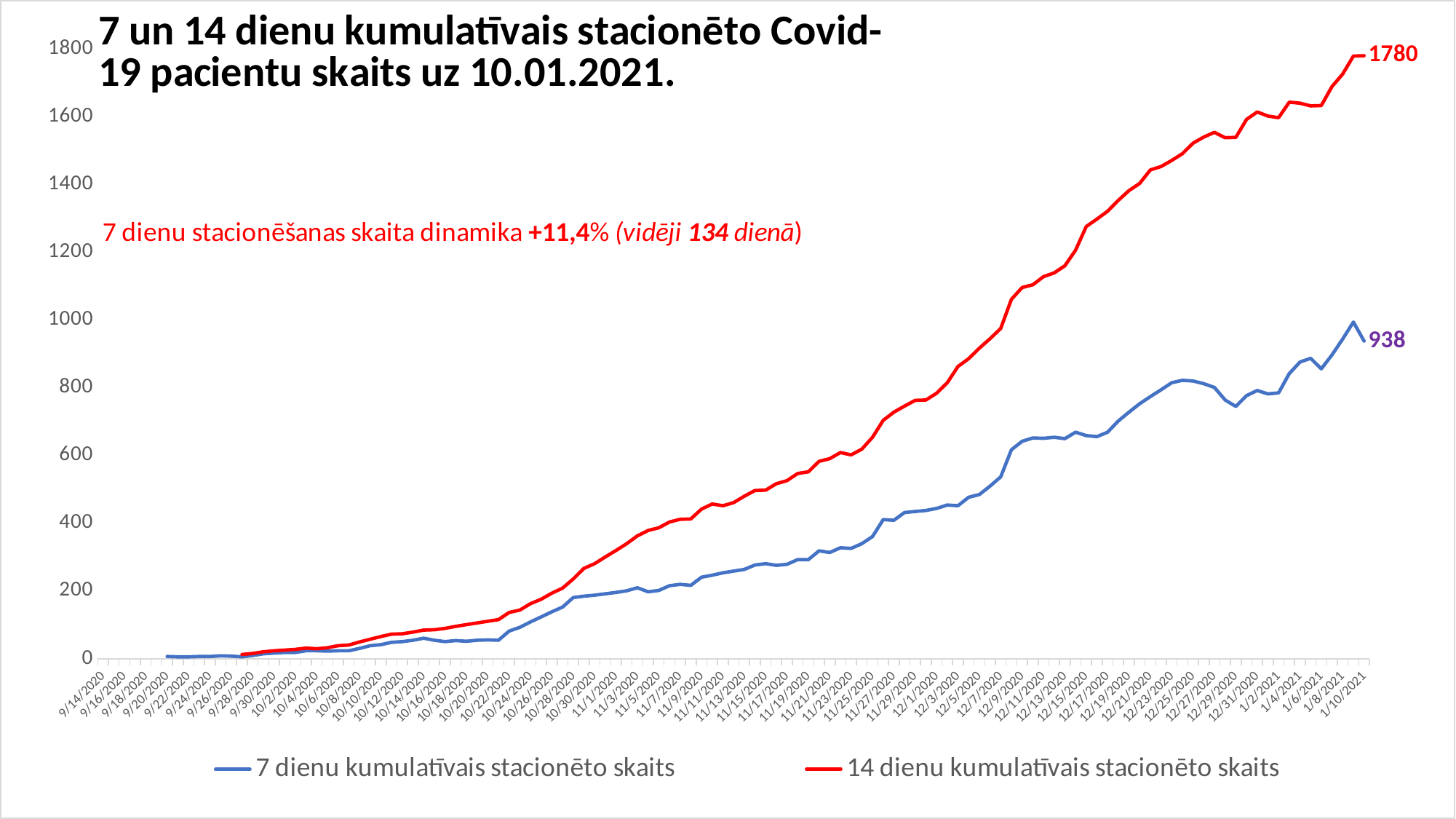
Is the value of the 7-day cumulative series on 12/1/2020 greater or less than 600? less Is the value of the 14-day cumulative series on 12/1/2020 greater or less than 600? greater What kind of chart is shown on the slide? line chart Which series has the higher value at the end of the chart, the 7-day or the 14-day cumulative count? 14 dienu kumulatīvais stacionēto skaits Do the values of the 14-day cumulative series generally rise or fall over time along the x axis? rise Is the value of the 14-day cumulative series on 11/1/2020 greater or less than 400? less What is the difference between the final labelled values of the 14-day and 7-day series? 842 What is the title of the chart? 7 un 14 dienu kumulatīvais stacionēto Covid-19 pacientu skaits uz 10.01.2021. What is the final value shown for the 14 dienu kumulatīvais stacionēto skaits series? 1780 How many series does the legend list? 2 What is the final value shown for the 7 dienu kumulatīvais stacionēto skaits series? 938 What colour is the line for the 7 dienu kumulatīvais stacionēto skaits series? blue